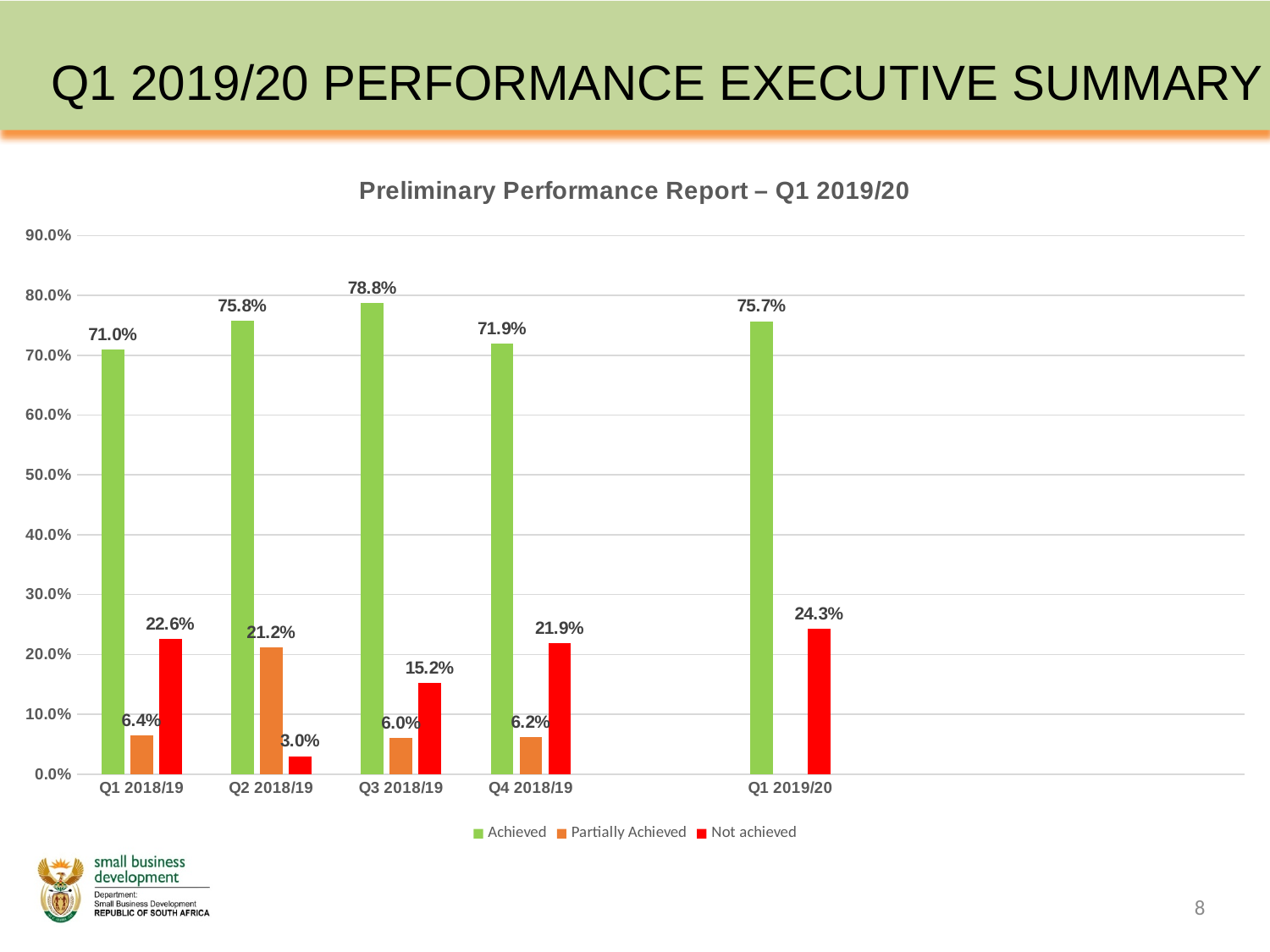
Is the Achieved value for Q4 2018/19 greater or less than 70.0%? greater Which quarter has the highest Achieved value? Q3 2018/19 What is the difference between the Achieved values for Q3 2018/19 and Q1 2018/19? 7.8% Which quarter has the lowest Not achieved value? Q2 2018/19 Which is larger, the Not achieved value for Q1 2018/19 or for Q4 2018/19? Q1 2018/19 What is the Achieved value for Q3 2018/19? 78.8% What is the title of the chart? Preliminary Performance Report – Q1 2019/20 What is the Partially Achieved value for Q2 2018/19? 21.2% How many quarters are shown on the x axis? 5 How many series does the legend list? 3 What is the Not achieved value for Q1 2019/20? 24.3% What kind of chart is shown on the slide? Bar chart